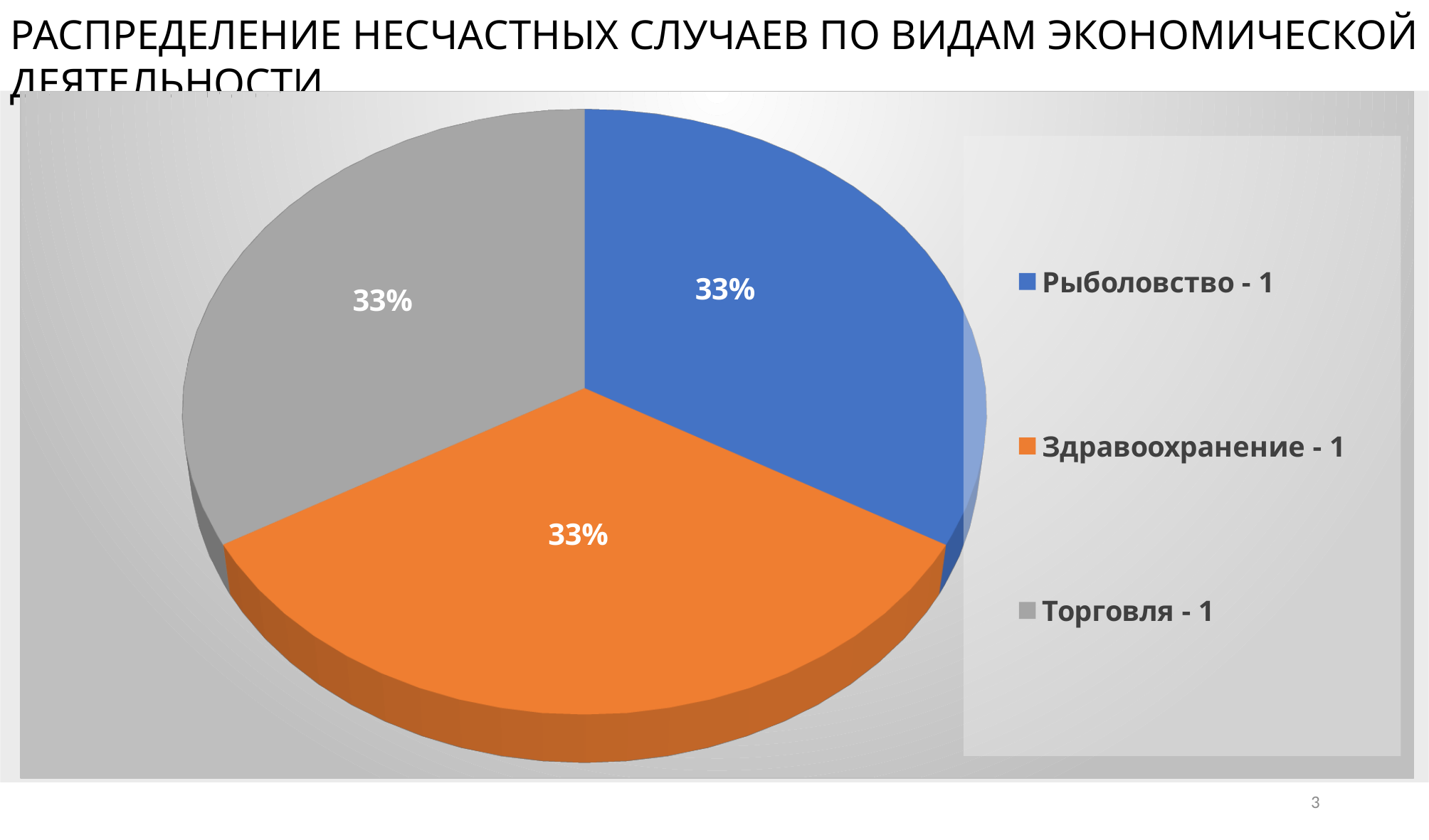
What share of the pie does Здравоохранение account for? 33% What is the data label shown on the grey slice of the pie chart? 33% What share of the pie does Рыболовство account for? 33% What share of the pie does Торговля account for? 33% Which legend entry is shown in orange? Здравоохранение - 1 How many slices does the pie chart have? 3 What is the title of the slide containing the pie chart? РАСПРЕДЕЛЕНИЕ НЕСЧАСТНЫХ СЛУЧАЕВ ПО ВИДАМ ЭКОНОМИЧЕСКОЙ ДЕЯТЕЛЬНОСТИ What is the data label shown on the blue slice of the pie chart? 33% How many entries does the legend of the pie chart list? 3 What kind of chart is shown on the slide? Pie chart What is the data label shown on the orange slice of the pie chart? 33%